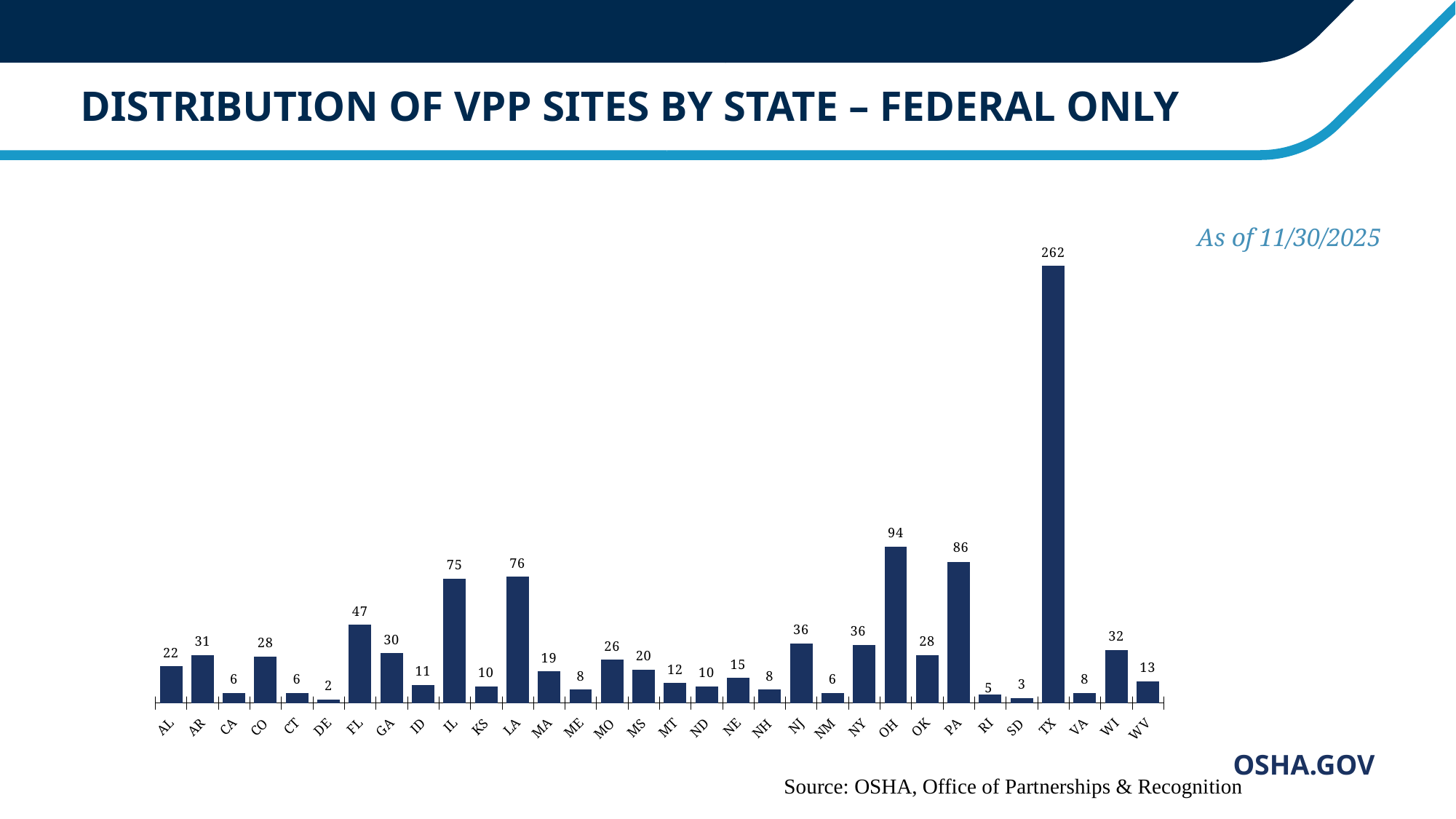
As of what date is the chart data reported? 11/30/2025 What kind of chart is shown on the slide? Bar chart Which state has the lowest value? DE What is the difference between the values for PA and OH? 8 What is the value for OH? 94 What is the value for FL? 47 Which is larger, the value for AR or the value for WI? WI Which is larger, the value for IL or the value for LA? LA Which state has the highest value? TX What is the difference between the values for TX and OH? 168 How many states are shown on the x axis? 32 What is the value for TX? 262